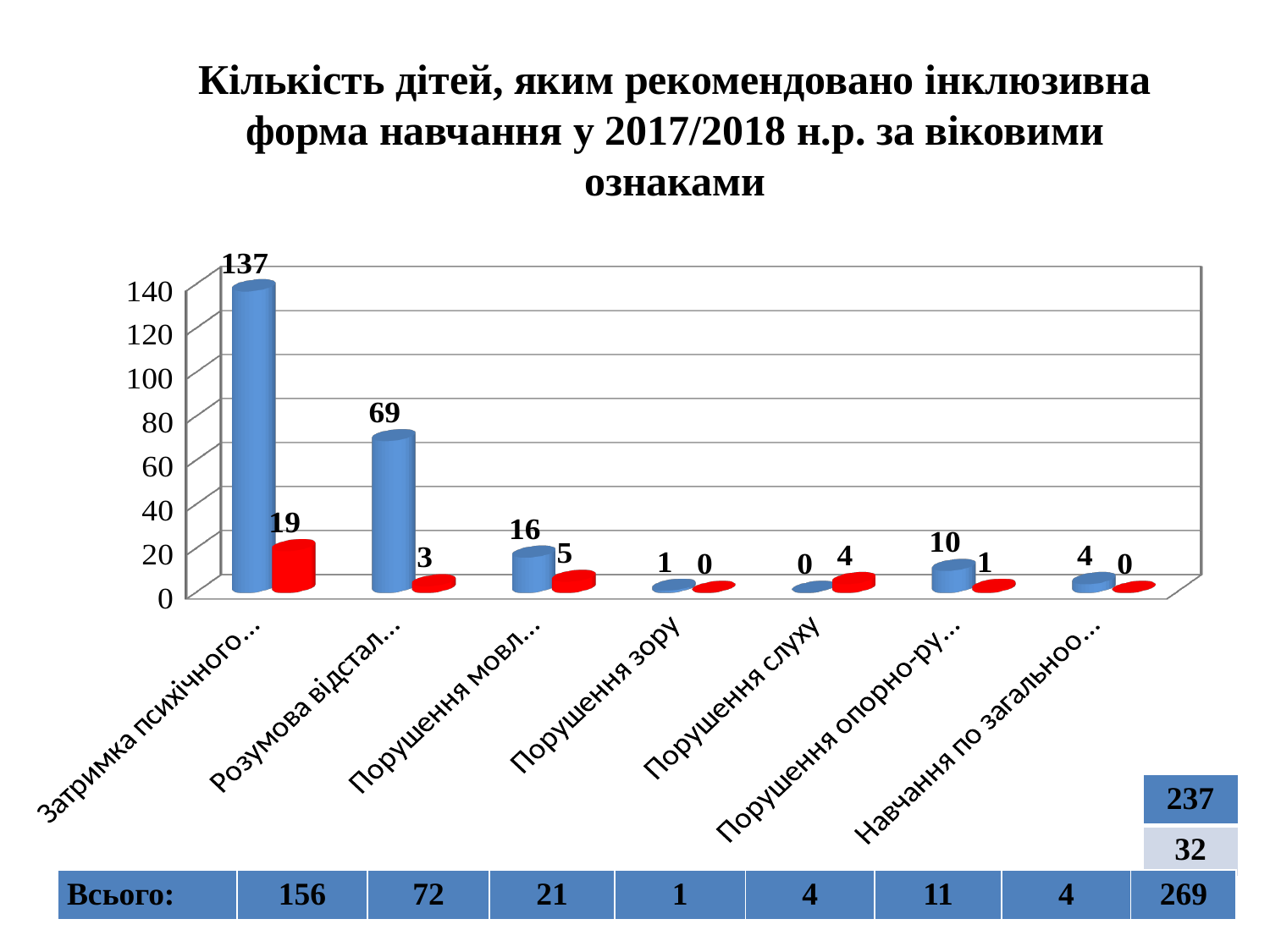
Which is larger for Порушення слуху, the blue bar or the red bar? the red bar What is the total (Всього) shown in the table for the first category? 156 How many categories are shown on the x axis of the chart? 7 What is the value of the blue bar for Порушення зору? 1 What is the difference between the blue bar and the red bar for the second category (Розумова відстал...)? 66 Which category has the highest blue bar? Затримка психічного... What is the overall total (Всього) shown at the right end of the table? 269 What kind of chart is shown on the slide? bar chart What is the value of the red bar for the first category (Затримка психічного...)? 19 What is the value of the red bar for Порушення слуху? 4 Is the blue bar for the second category (Розумова відстал...) greater or less than 60? greater What is the value of the blue bar for the first category (Затримка психічного...)? 137